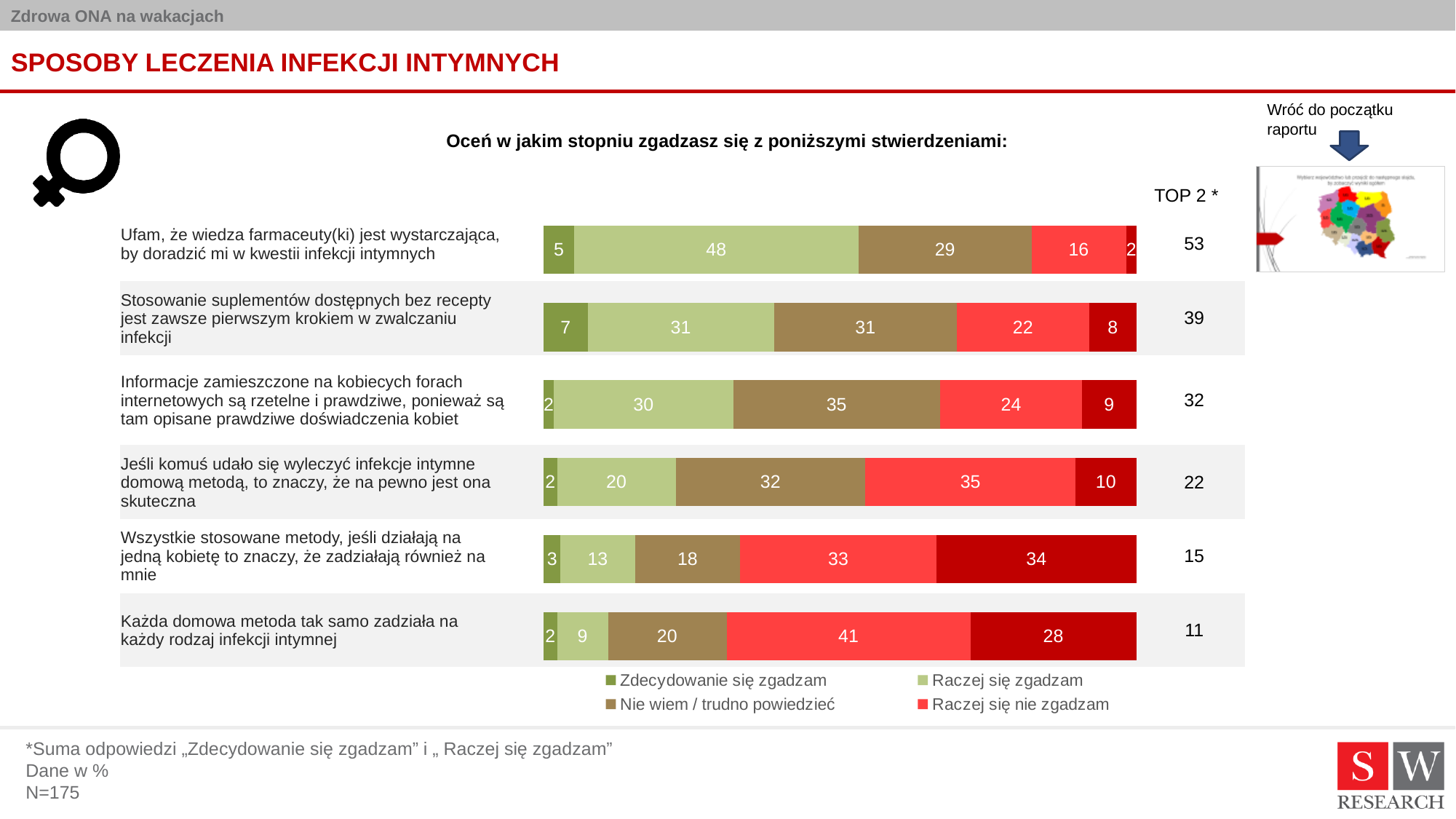
What is the difference between the 'Raczej się nie zgadzam' values for 'Każda domowa metoda tak samo zadziała na każdy rodzaj infekcji intymnej' and 'Ufam, że wiedza farmaceuty(ki) jest wystarczająca...'? 25 How many series does the legend list? 4 What is the TOP 2 value for the statement 'Stosowanie suplementów dostępnych bez recepty jest zawsze pierwszym krokiem w zwalczaniu infekcji'? 39 What is the 'Zdecydowanie się zgadzam' value for the statement 'Wszystkie stosowane metody, jeśli działają na jedną kobietę to znaczy, że zadziałają również na mnie'? 3 What is the sample size (N) stated on the slide? N=175 What is the 'Nie wiem / trudno powiedzieć' value for the statement 'Informacje zamieszczone na kobiecych forach internetowych są rzetelne i prawdziwe...'? 35 What kind of chart is shown on the slide? stacked bar chart Which statement has the highest TOP 2 value? Ufam, że wiedza farmaceuty(ki) jest wystarczająca, by doradzić mi w kwestii infekcji intymnych Which is larger: the 'Raczej się zgadzam' value for 'Stosowanie suplementów dostępnych bez recepty...' or for 'Jeśli komuś udało się wyleczyć infekcje intymne domową metodą...'? Stosowanie suplementów dostępnych bez recepty... What is the 'Raczej się zgadzam' value for the statement 'Ufam, że wiedza farmaceuty(ki) jest wystarczająca, by doradzić mi w kwestii infekcji intymnych'? 48 How many statements (categories) are plotted in the chart? 6 Which statement has the lowest TOP 2 value? Każda domowa metoda tak samo zadziała na każdy rodzaj infekcji intymnej